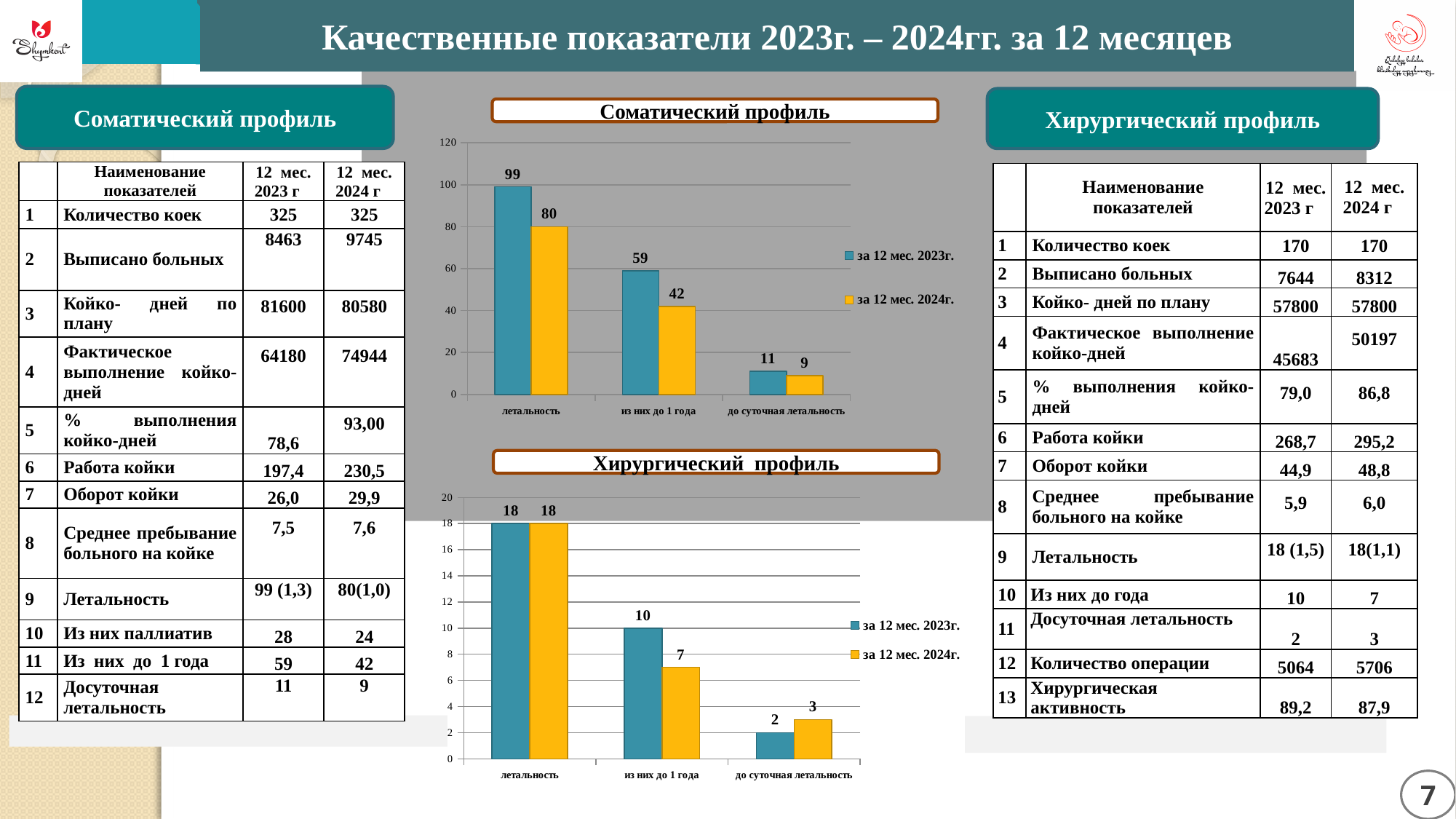
In the 'Хирургический профиль' chart, what is the value for 'из них до 1 года' for 'за 12 мес. 2023г.'? 10 In the 'Хирургический профиль' chart, what is the difference between the 2023 and 2024 values for 'из них до 1 года'? 3 In the 'Хирургический профиль' chart, what is the value for 'до суточная летальность' for 'за 12 мес. 2024г.'? 3 What type of chart is the 'Соматический профиль' chart? bar chart In the 'Соматический профиль' chart, what is the difference between the 2023 and 2024 values for 'летальность'? 19 In the 'Соматический профиль' chart, what is the value for 'летальность' for 'за 12 мес. 2023г.'? 99 In the 'Соматический профиль' chart, which category has the lowest value for 'за 12 мес. 2023г.'? до суточная летальность How many categories are shown on the x axis of the 'Хирургический профиль' chart? 3 In the 'Хирургический профиль' chart, which is larger for 'до суточная летальность': the 2023 value or the 2024 value? 2024 In the 'Хирургический профиль' chart, which category has the highest value for 'за 12 мес. 2024г.'? летальность In the 'Соматический профиль' chart, how many series does the legend list? 2 In the 'Соматический профиль' chart, what is the value for 'из них до 1 года' for 'за 12 мес. 2024г.'? 42